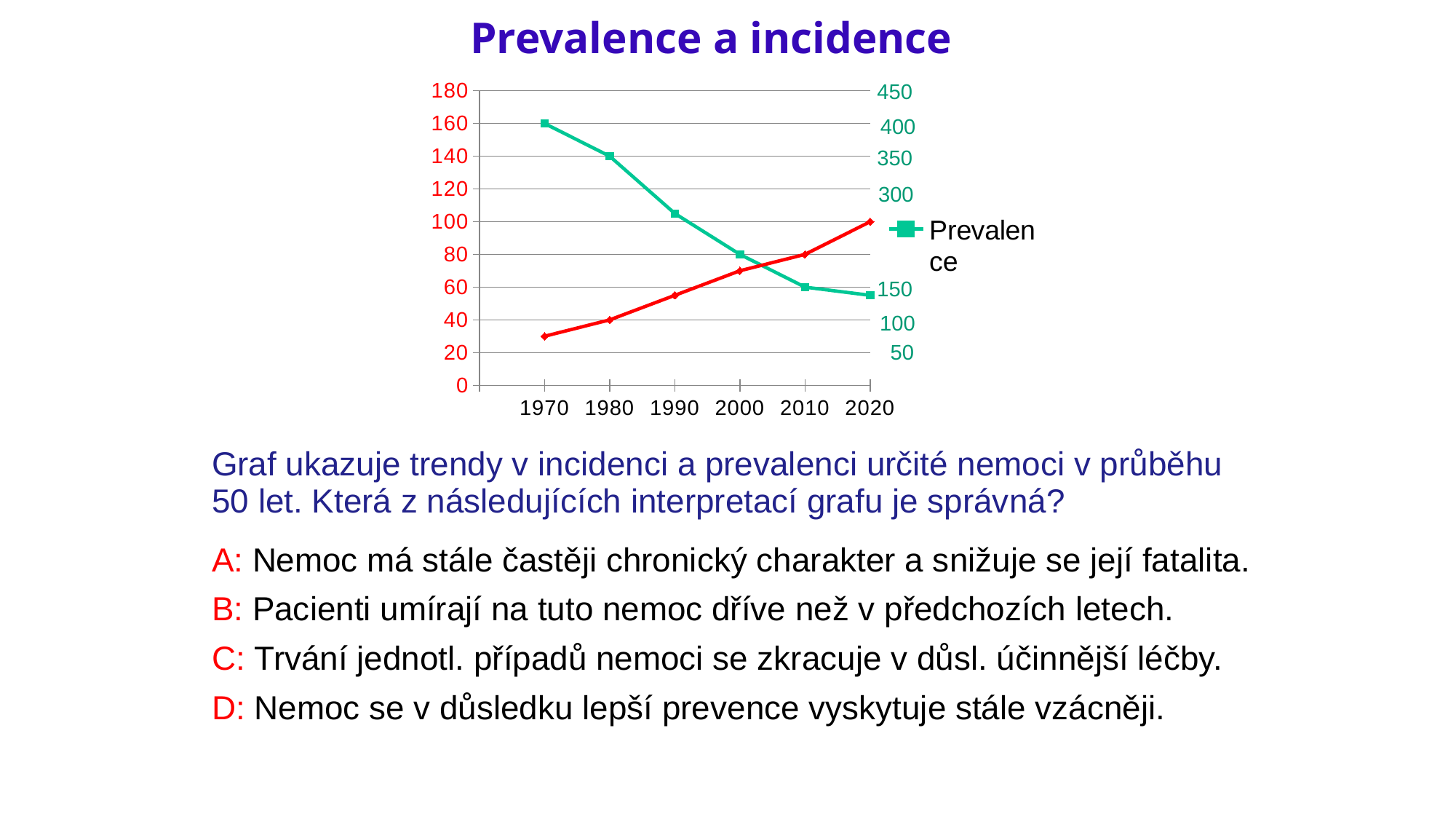
Does the Prevalence line rise or fall from 1970 to 2020? fall Is the value of the red line in 2000 greater or less than 80 on the left axis? less Does the red line rise or fall from 1970 to 2020? rise What is the title of the chart? Prevalence a incidence What is the difference between the Prevalence values in 1970 and 1980? 20 How many years are shown on the x axis of the chart? 6 What kind of chart is shown on the slide? line chart How many series does the chart's legend list? 1 In which year is Prevalence highest? 1970